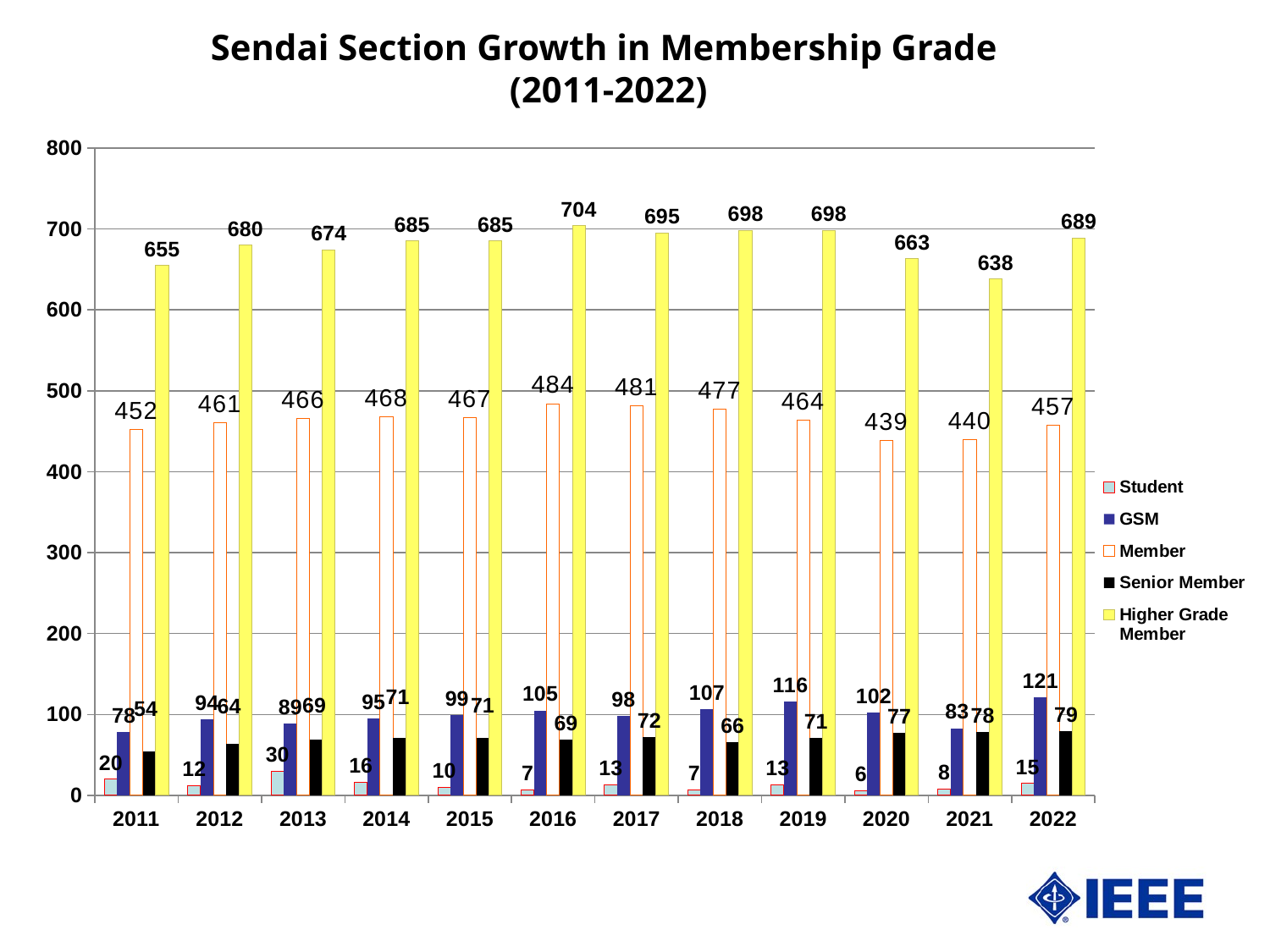
In which year is the Student value lowest? 2020 Which year has the larger GSM value, 2019 or 2022? 2022 What is the title of the chart? Sendai Section Growth in Membership Grade (2011-2022) What is the difference between the Member value in 2016 and in 2011? 32 How many series does the legend list? 5 In which year is the Higher Grade Member value highest? 2016 What kind of chart is shown on the slide? bar chart How many years are shown on the x axis? 12 What is the value for Higher Grade Member in 2016? 704 What is the value for Member in 2020? 439 What is the value for Senior Member in 2022? 79 In which year is the GSM value highest? 2022